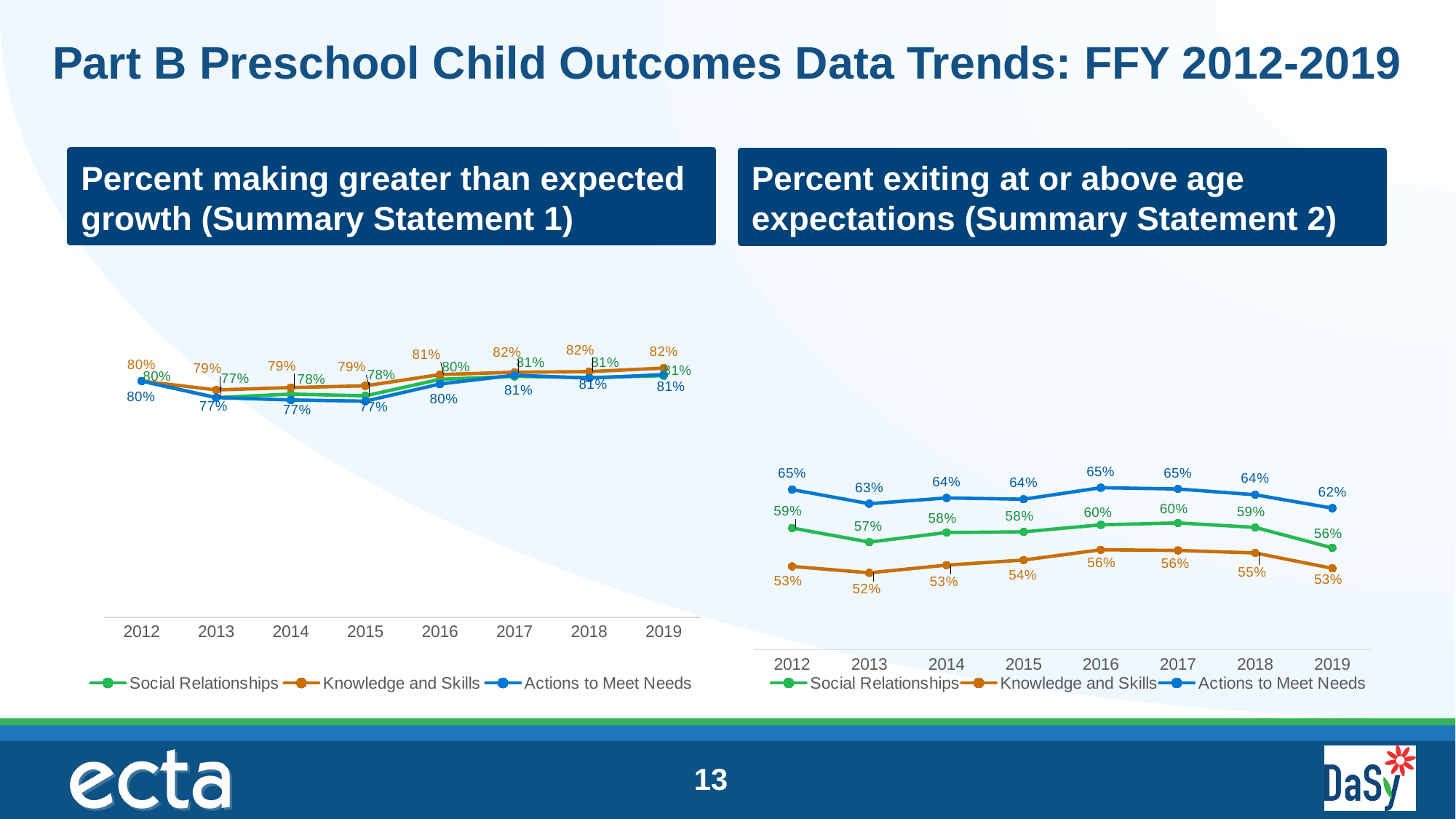
In the 'Percent exiting at or above age expectations (Summary Statement 2)' chart, which year has the lowest value for Actions to Meet Needs? 2019 In the 'Percent exiting at or above age expectations (Summary Statement 2)' chart, what is the value for Social Relationships in 2019? 56% In the 'Percent exiting at or above age expectations (Summary Statement 2)' chart, what is the difference between Actions to Meet Needs and Knowledge and Skills in 2012? 12% In the 'Percent making greater than expected growth (Summary Statement 1)' chart, what is the value for Knowledge and Skills in 2019? 82% What type of chart is the 'Percent making greater than expected growth (Summary Statement 1)' chart? Line chart In the 'Percent exiting at or above age expectations (Summary Statement 2)' chart, which is larger in 2016: Social Relationships or Knowledge and Skills? Social Relationships In the 'Percent making greater than expected growth (Summary Statement 1)' chart, what is the difference between the Knowledge and Skills values in 2019 and 2013? 3% In the 'Percent exiting at or above age expectations (Summary Statement 2)' chart, what is the value for Actions to Meet Needs in 2012? 65% How many years are shown on the x axis of the 'Percent making greater than expected growth (Summary Statement 1)' chart? 8 In the 'Percent exiting at or above age expectations (Summary Statement 2)' chart, does the Actions to Meet Needs value rise or fall from 2018 to 2019? Fall How many series does the legend of the 'Percent exiting at or above age expectations (Summary Statement 2)' chart list? 3 In the 'Percent exiting at or above age expectations (Summary Statement 2)' chart, what is the value for Knowledge and Skills in 2013? 52%